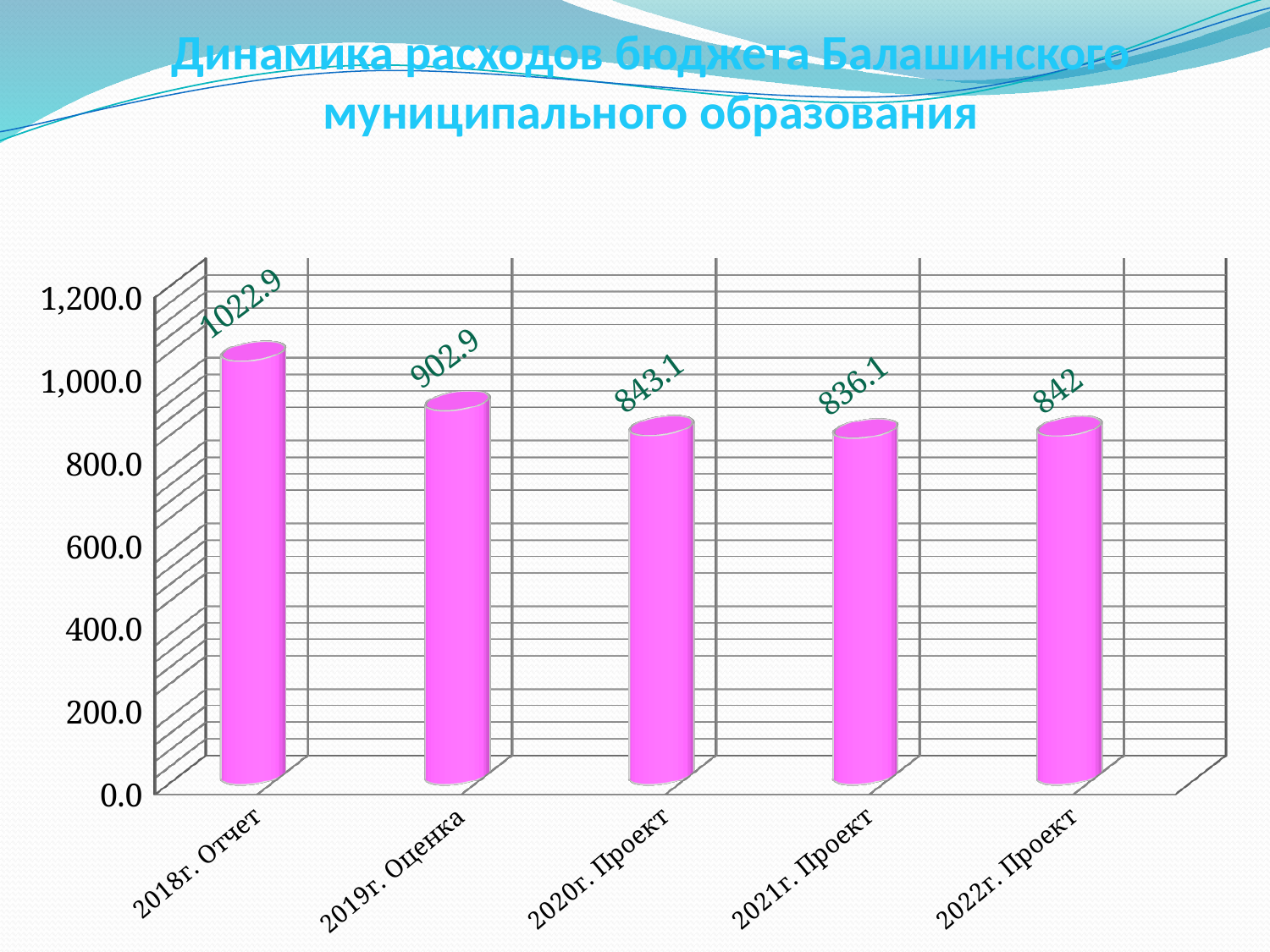
What is the difference between the values for 2018г. Отчет and 2019г. Оценка? 120.0 What is the difference between the values for 2020г. Проект and 2021г. Проект? 7.0 What is the value for 2019г. Оценка? 902.9 What is the value for 2022г. Проект? 842 Which is larger, the value for 2019г. Оценка or the value for 2020г. Проект? 2019г. Оценка What is the value for 2018г. Отчет? 1022.9 Which category has the lowest value? 2021г. Проект Do the values generally rise or fall from 2018г. Отчет to 2021г. Проект? Fall What is the value for 2021г. Проект? 836.1 What kind of chart is shown on the slide? Bar chart Which category has the highest value? 2018г. Отчет How many categories are shown on the x axis? 5